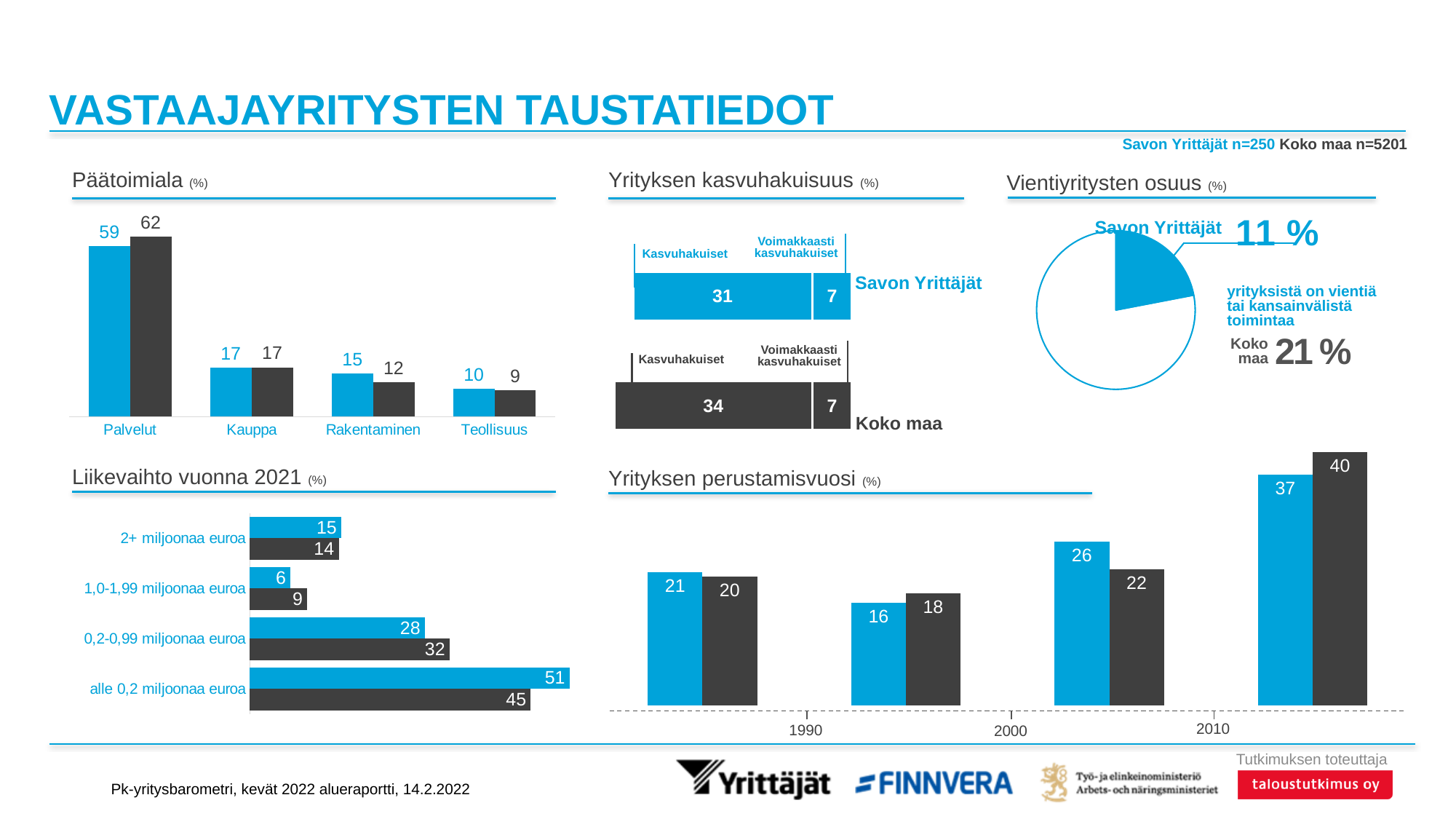
In the Liikevaihto vuonna 2021 chart, what is the Savon Yrittäjät (blue) value for alle 0,2 miljoonaa euroa? 51 In the Yrityksen perustamisvuosi chart, what is the Koko maa (dark bar) value for the rightmost group? 40 In the Yrityksen kasvuhakuisuus chart, what is the total of the Savon Yrittäjät stacked bar (Kasvuhakuiset plus Voimakkaasti kasvuhakuiset)? 38 In the Liikevaihto vuonna 2021 chart, which is larger for 1,0-1,99 miljoonaa euroa: the Savon Yrittäjät value or the Koko maa value? Koko maa In the Päätoimiala chart, which category has the lowest value for Savon Yrittäjät? Teollisuus In the Päätoimiala chart, which category has the highest value for Koko maa? Palvelut In the Päätoimiala chart, what is the value for Palvelut for Savon Yrittäjät (blue bar)? 59 In the Päätoimiala chart, what is the Koko maa (dark bar) value for Rakentaminen? 12 In the Liikevaihto vuonna 2021 chart, what is the difference between the Koko maa and Savon Yrittäjät values for 0,2-0,99 miljoonaa euroa? 4 In the Yrityksen kasvuhakuisuus chart, what is the Kasvuhakuiset value for Koko maa? 34 In the Päätoimiala chart, how many categories are shown on the x axis? 4 In the Vientiyritysten osuus chart, what share of Savon Yrittäjät companies have export or international activity? 11 %